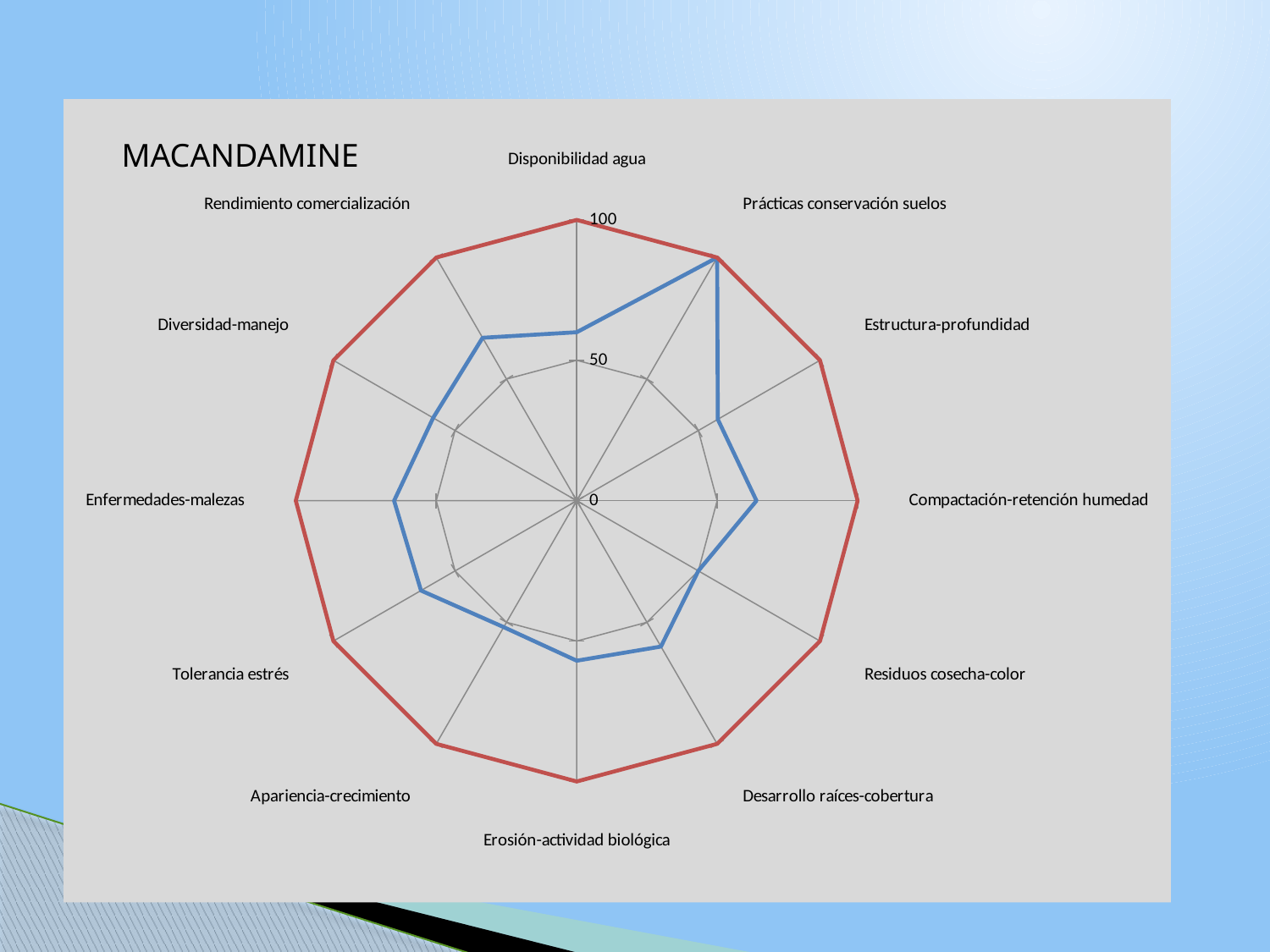
How many categories (axes) does the radar chart have? 12 Is the blue series value for Enfermedades-malezas greater or less than 50? greater What value does the red series have for Disponibilidad agua? 100 For which category does the blue series reach its highest value? Prácticas conservación suelos What kind of chart is shown on the slide? Radar chart How many data series (lines) are plotted on the radar chart? 2 Which series has the larger value for Rendimiento comercialización, the red series or the blue series? The red series What is the title shown above the radar chart? MACANDAMINE What value does the red series have for Tolerancia estrés? 100 Is the blue series value for Compactación-retención humedad greater or less than 100? less What is the maximum value shown on the radar chart's axis scale? 100 Is the blue series value for Disponibilidad agua greater or less than 50? greater